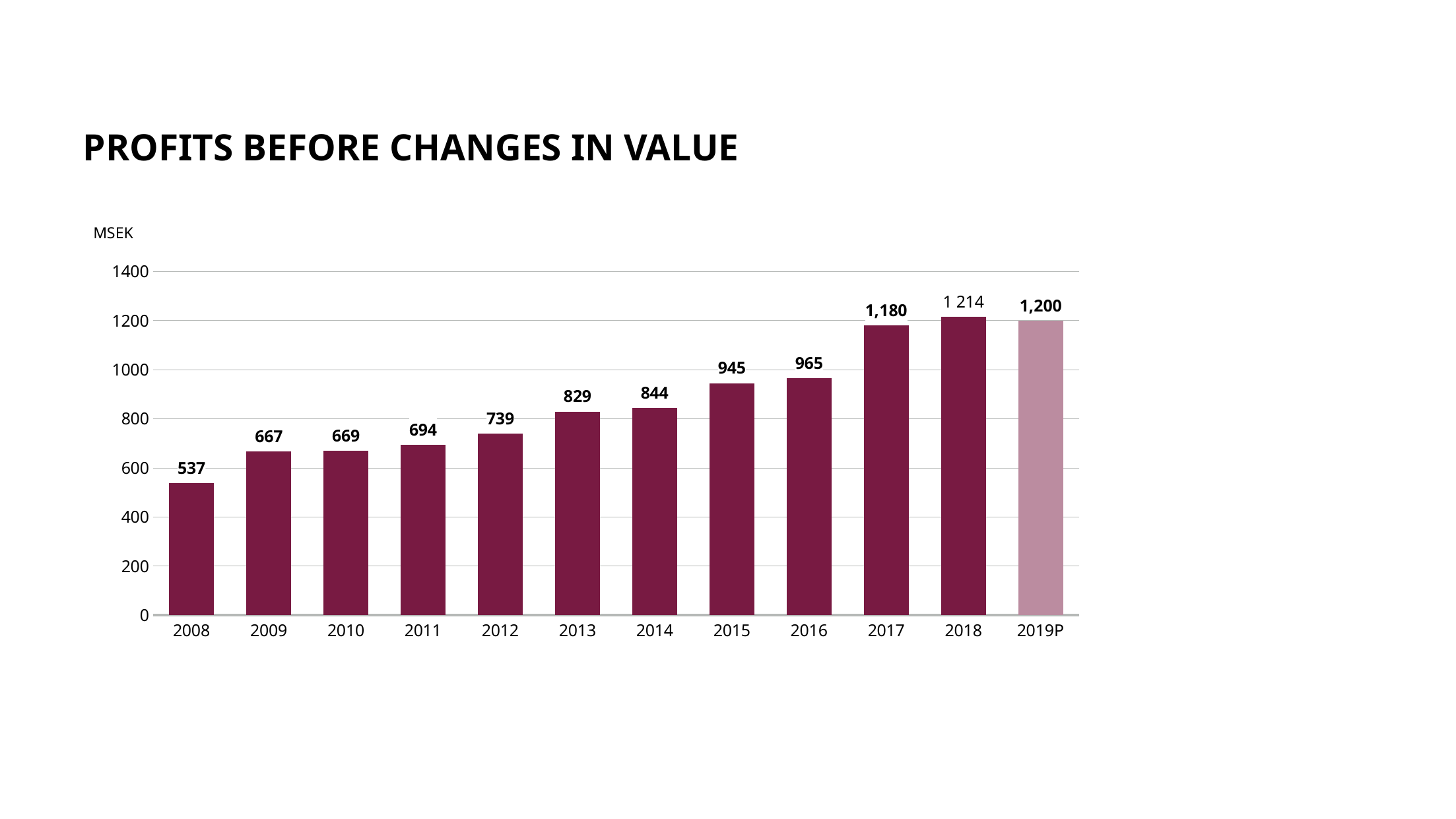
What is the value for 2017? 1,180 What is the difference between the values for 2016 and 2015? 20 Which year has the highest value? 2018 What unit is shown on the y axis of the chart? MSEK What is the difference between the values for 2009 and 2008? 130 Which year has the lowest value? 2008 What kind of chart is shown on the slide? bar chart How many bars are shown in the chart? 12 What is the value for 2013? 829 Which is larger, the value for 2012 or the value for 2014? 2014 What is the value for 2008? 537 What is the value for 2019P? 1,200